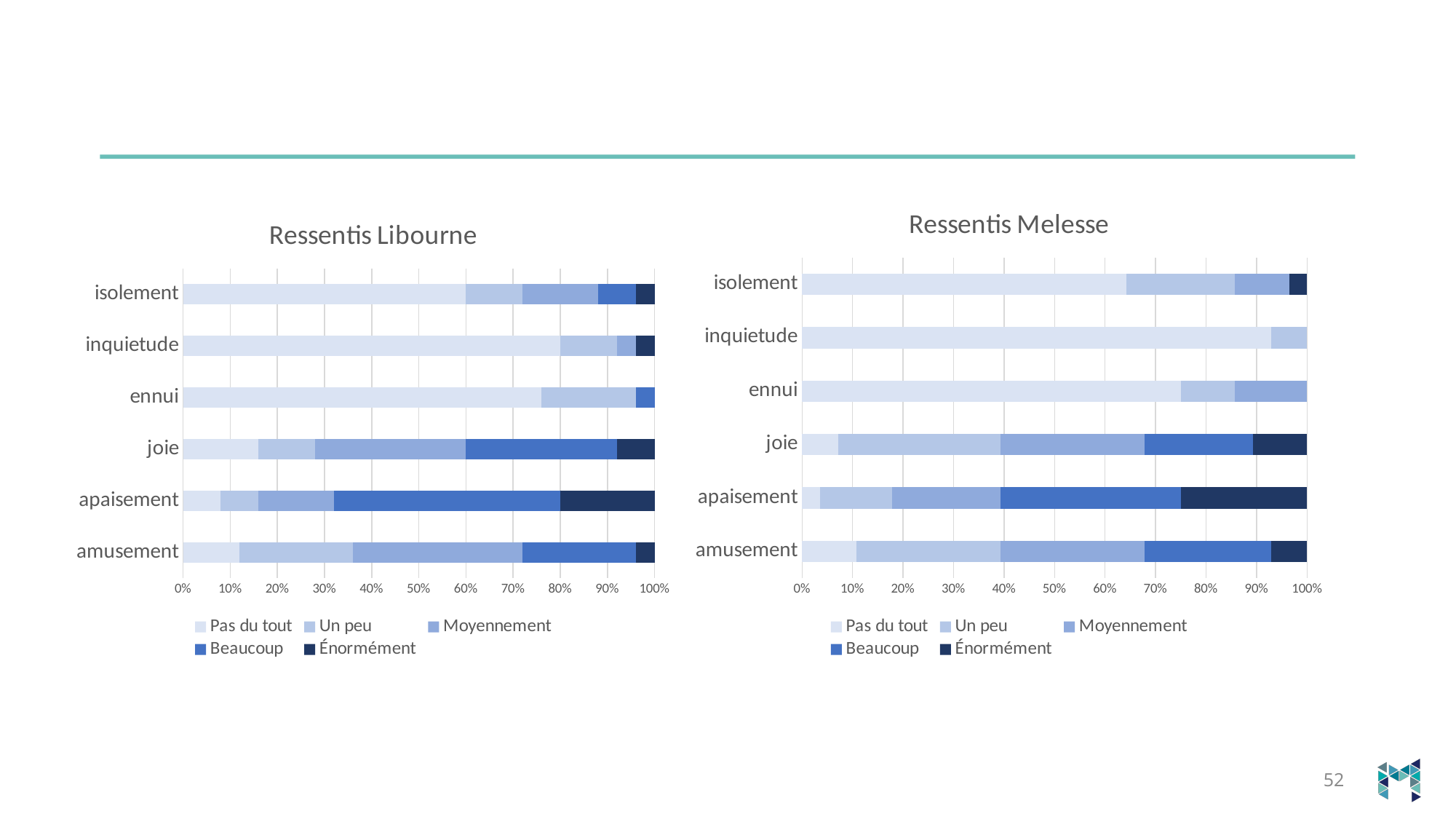
How many categories are shown on the "Ressentis Melesse" chart? 6 In the "Ressentis Libourne" chart, which category has the smallest "Pas du tout" share? apaisement What kind of chart is "Ressentis Libourne"? Stacked bar chart In the "Ressentis Libourne" chart, which legend entry is shown in the darkest blue? Énormément What is the title of the chart on the right of the slide? Ressentis Melesse In the "Ressentis Libourne" chart, is the "Pas du tout" share for joie greater or less than 20%? less In the "Ressentis Melesse" chart, is the "Pas du tout" share for apaisement greater or less than 10%? less In the "Ressentis Melesse" chart, which category has the largest "Pas du tout" share? inquietude In the "Ressentis Libourne" chart, is the "Pas du tout" share for inquietude greater or less than 70%? greater How many series does the legend of the "Ressentis Libourne" chart list? 5 In the "Ressentis Libourne" chart, which has the larger "Pas du tout" share, isolement or joie? isolement